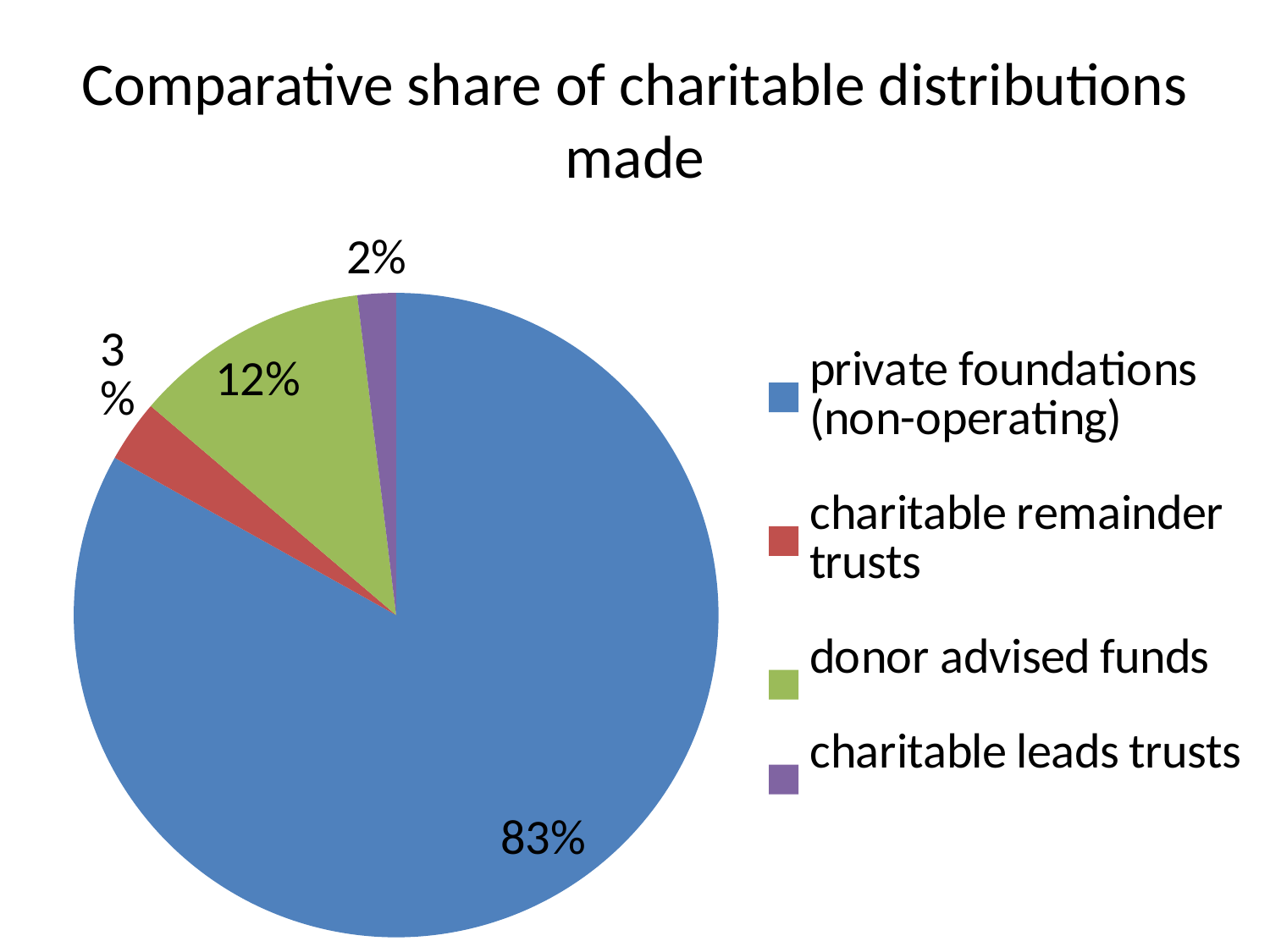
What colour is the slice for donor advised funds? green What share of charitable distributions is made by charitable remainder trusts? 3% Which category has the largest share of charitable distributions? private foundations (non-operating) What is the title of the chart? Comparative share of charitable distributions made Which category has the smallest share of charitable distributions? charitable leads trusts What share of charitable distributions is made by charitable leads trusts? 2% What kind of chart is shown on the slide? pie chart How many categories does the pie chart show? 4 Which has a larger share, donor advised funds or charitable remainder trusts? donor advised funds What share of charitable distributions is made by private foundations (non-operating)? 83% What is the difference in share between private foundations (non-operating) and donor advised funds? 71% What share of charitable distributions is made by donor advised funds? 12%